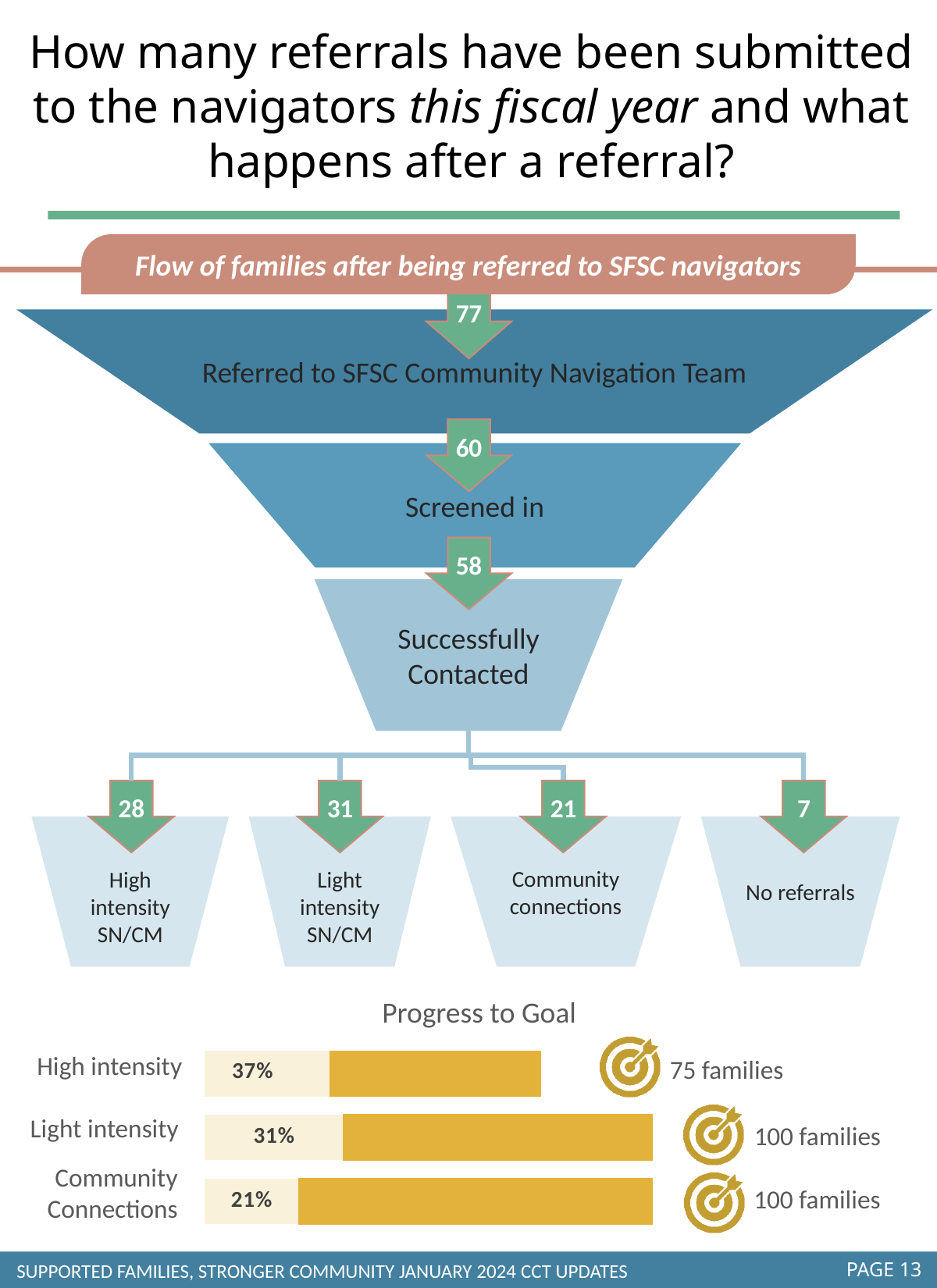
In the funnel diagram, how many families were referred to the SFSC Community Navigation Team? 77 In the funnel diagram, how many families were successfully contacted? 58 What kind of chart is the Progress to Goal chart? Bar chart In the Progress to Goal chart, which category has the lowest percentage? Community Connections In the funnel diagram, how many families went to Light intensity SN/CM? 31 In the funnel diagram, how many families were screened in? 60 In the funnel diagram, which of the four outcome categories at the bottom has the fewest families? No referrals In the Progress to Goal chart, what percentage is shown for High intensity? 37% In the Progress to Goal chart, what is the goal for Community Connections? 100 families In the funnel diagram, how many outcome categories branch off from Successfully Contacted? 4 In the funnel diagram, what is the difference between the number referred and the number screened in? 17 In the funnel diagram, which of the four outcome categories at the bottom has the most families? Light intensity SN/CM